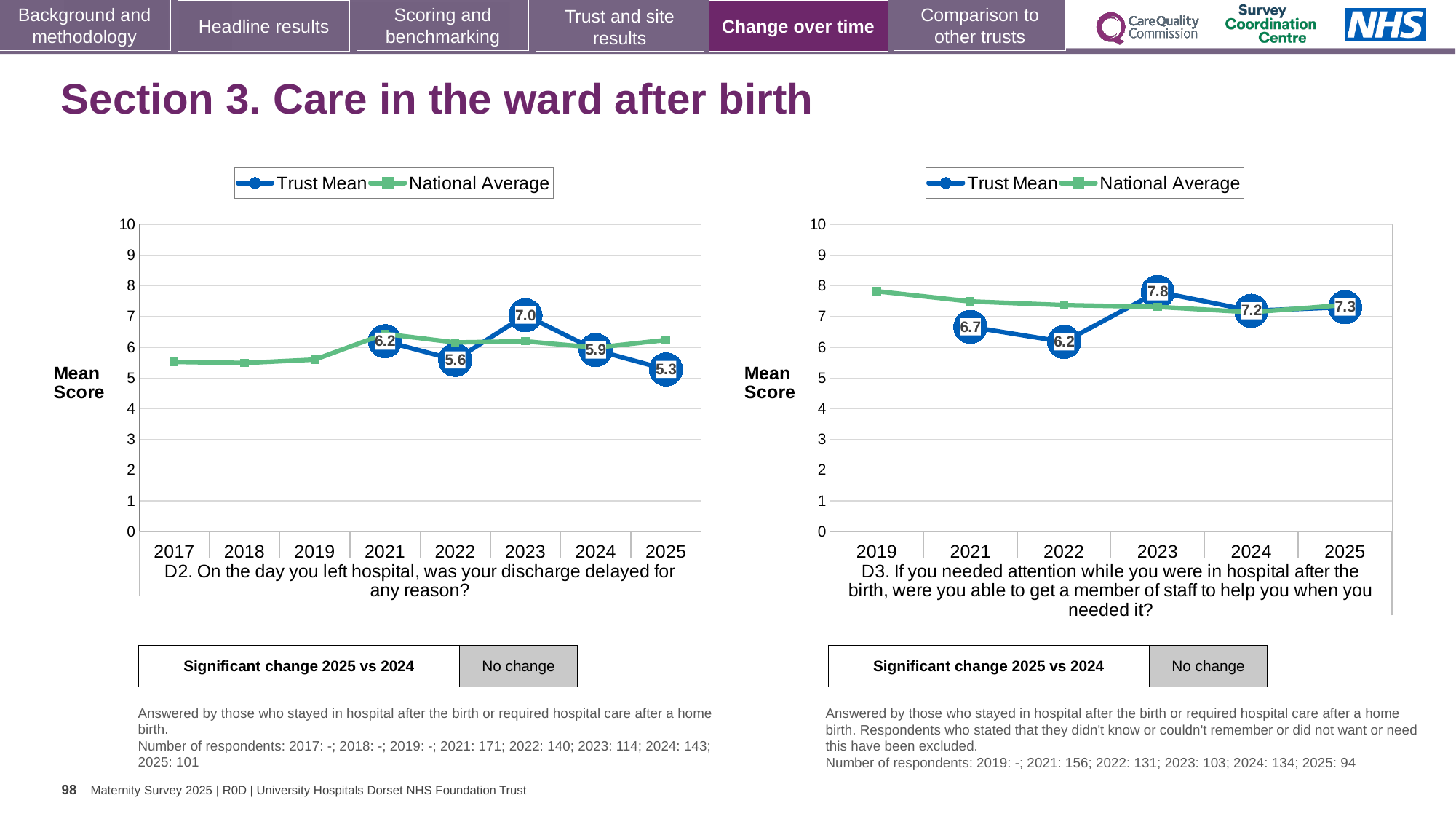
In the right chart (D3, able to get a member of staff to help), which year has the lowest Trust Mean? 2022 In the right chart (D3, able to get a member of staff to help), is the National Average for 2019 greater or less than 7? greater In the left chart (D2, discharge delayed), how many years are shown on the x axis? 8 In the left chart (D2, discharge delayed), what is the Trust Mean for 2025? 5.3 In the left chart (D2, discharge delayed), what is the Trust Mean for 2023? 7.0 In the left chart (D2, discharge delayed), which year has the lowest Trust Mean? 2025 In the right chart (D3, able to get a member of staff to help), is the Trust Mean for 2025 larger or smaller than for 2021? larger What kind of chart is the left chart (D2, discharge delayed)? Line chart In the right chart (D3, able to get a member of staff to help), what is the Trust Mean for 2023? 7.8 In the left chart (D2, discharge delayed), which year has the highest Trust Mean? 2023 In the left chart (D2, discharge delayed), what is the difference between the Trust Mean in 2023 and in 2022? 1.4 How many series does the legend of the right chart (D3) list? 2